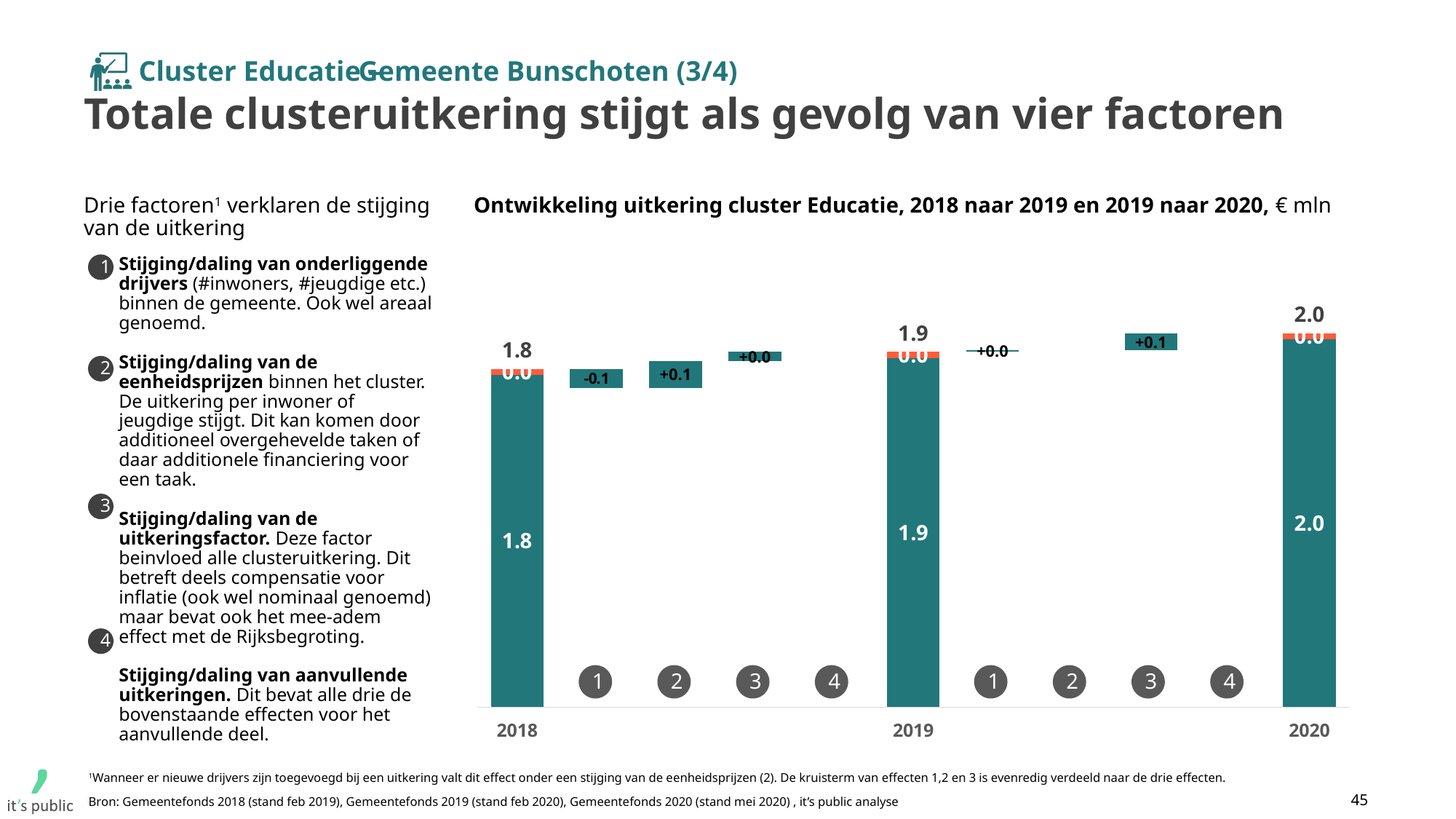
What is the total uitkering for cluster Educatie in 2019? 1.9 Which year has the lowest total uitkering? 2018 What is the effect of factor 2 on the uitkering from 2018 to 2019? +0.1 What is the total uitkering for cluster Educatie in 2020? 2.0 Is the total uitkering larger in 2019 or in 2018? 2019 What kind of chart is shown on the slide? bar chart What is the difference between the total uitkering in 2020 and in 2018? 0.2 Do the total uitkering values rise or fall from 2018 to 2020? rise In what unit are the values in the chart expressed? € mln What is the effect of factor 1 on the uitkering from 2018 to 2019? -0.1 What is the total uitkering for cluster Educatie in 2018? 1.8 Which year has the highest total uitkering? 2020